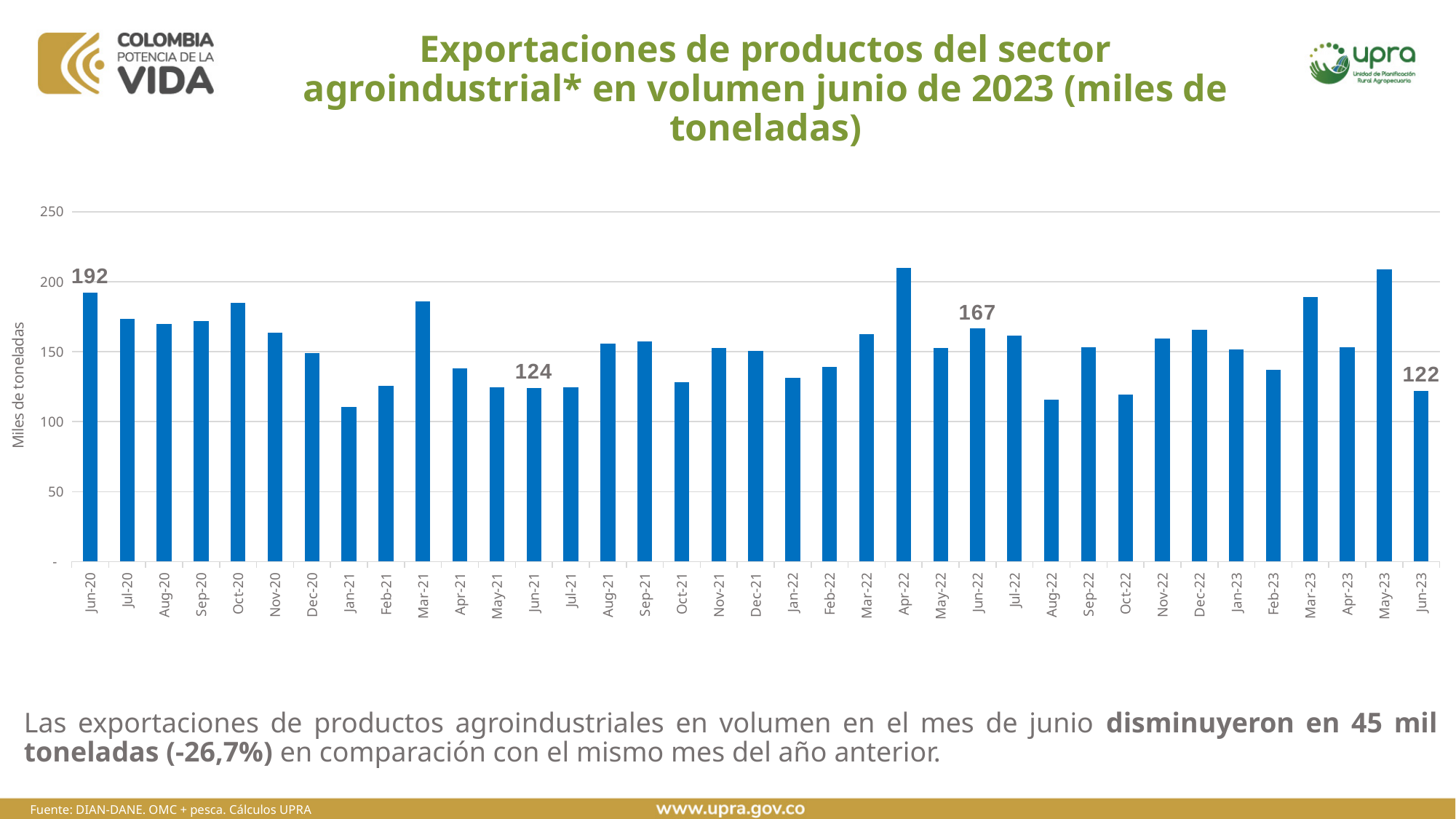
What is the value for Jun-23? 122 What is the label of the vertical axis? Miles de toneladas Which is larger, the value for Jun-20 or the value for Jun-22? Jun-20 What is the difference between the values for Jun-22 and Jun-23? 45 How many months (bars) are shown on the chart? 37 Is the value for Jan-21 greater or less than 150? less What is the value for Jun-22? 167 What kind of chart is shown on the slide? bar chart What is the value for Jun-21? 124 What is the value for Jun-20? 192 What is the difference between the values for Jun-20 and Jun-23? 70 Is the value for Apr-22 greater or less than 200? greater